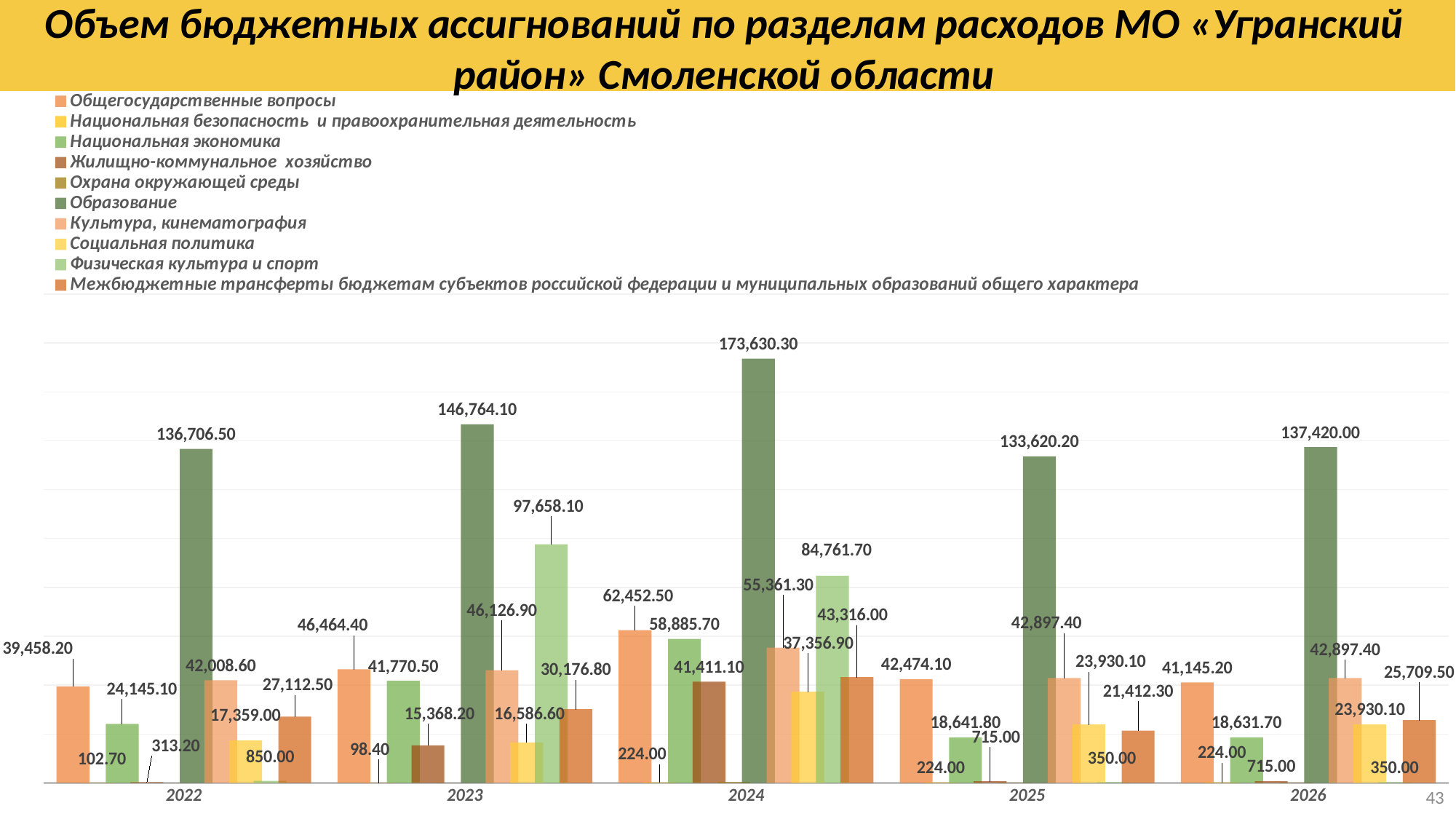
What is the value for Общегосударственные вопросы in 2024? 62,452.50 How many series does the legend list? 10 Does the value for Образование rise or fall from 2022 to 2024? rise What is the value for Образование in 2024? 173,630.30 What is the difference between the Образование values for 2024 and 2023? 26,866.20 What kind of chart is shown on the slide? bar chart Which series is shown in dark green in the legend? Образование Which year has the larger value for Физическая культура и спорт, 2023 or 2024? 2023 What is the value for Межбюджетные трансферты бюджетам субъектов российской федерации и муниципальных образований общего характера in 2026? 25,709.50 In which year is the value for Образование the highest? 2024 How many years are shown on the x axis? 5 In which year is the value for Образование the lowest? 2025